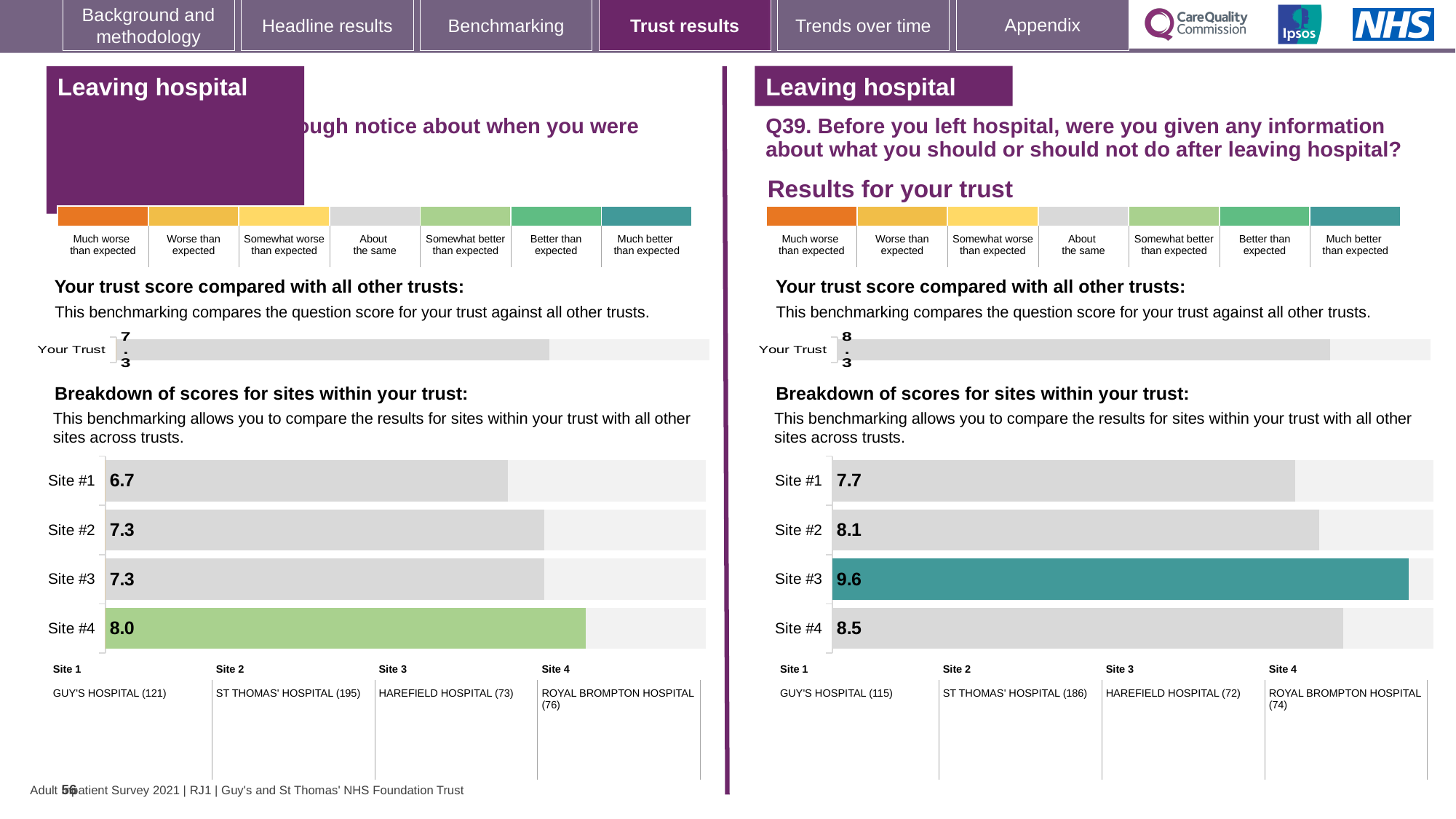
On the right-hand chart (Q39), what is the score for Site #3? 9.6 On the left-hand chart, what is the score for Site #1? 6.7 On the right-hand chart (Q39), what is the 'Your Trust' score shown in the trust benchmarking bar? 8.3 On the left-hand chart, what is the difference between the scores for Site #4 and Site #1? 1.3 On the right-hand chart (Q39), which has the higher score, Site #2 or Site #4? Site #4 On the right-hand chart (Q39), what is the score for Site #1? 7.7 What type of chart is used for the breakdown of scores for sites on the right-hand side (Q39)? Bar chart On the left-hand chart, what is the score for Site #4? 8.0 On the right-hand chart (Q39), which site has the highest score? Site #3 How many sites are shown in the site breakdown chart on the right-hand side (Q39)? 4 On the right-hand chart (Q39), what is the difference between the scores for Site #3 and Site #1? 1.9 On the left-hand chart, which site has the lowest score? Site #1